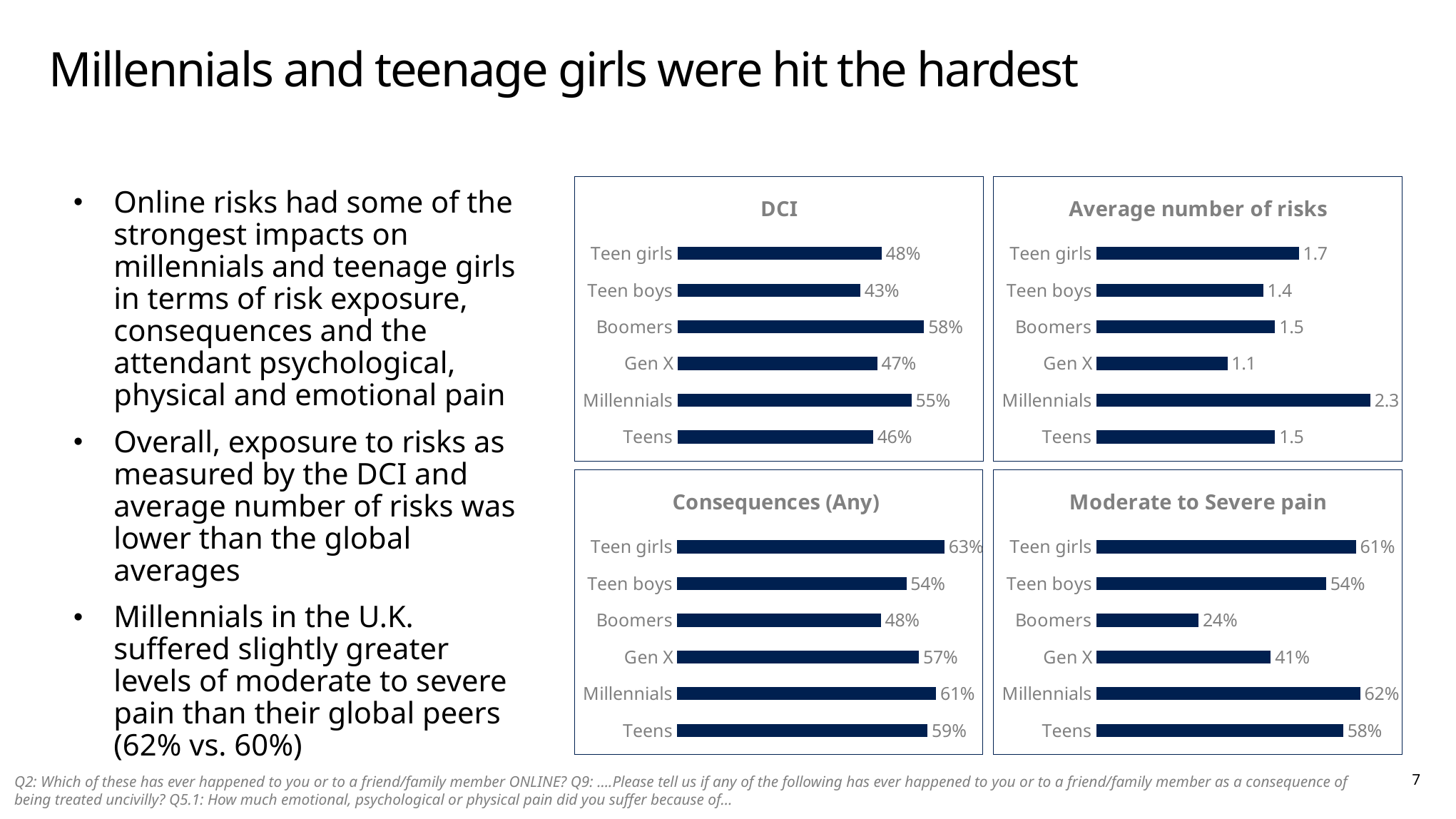
In the DCI chart, what is the value for Boomers? 58% In the Average number of risks chart, which category has the highest value? Millennials In the Consequences (Any) chart, what is the difference between Teen girls and Teen boys? 9% In the DCI chart, which category has the lowest value? Teen boys How many categories are shown in the DCI chart? 6 In the Moderate to Severe pain chart, which category has the lowest value? Boomers In the Average number of risks chart, what is the value for Millennials? 2.3 How many charts are shown on the slide? 4 What kind of chart is the Moderate to Severe pain chart? Bar chart In the Average number of risks chart, which is larger, Teen girls or Teen boys? Teen girls In the Consequences (Any) chart, what is the value for Teen girls? 63% In the Moderate to Severe pain chart, what is the value for Boomers? 24%